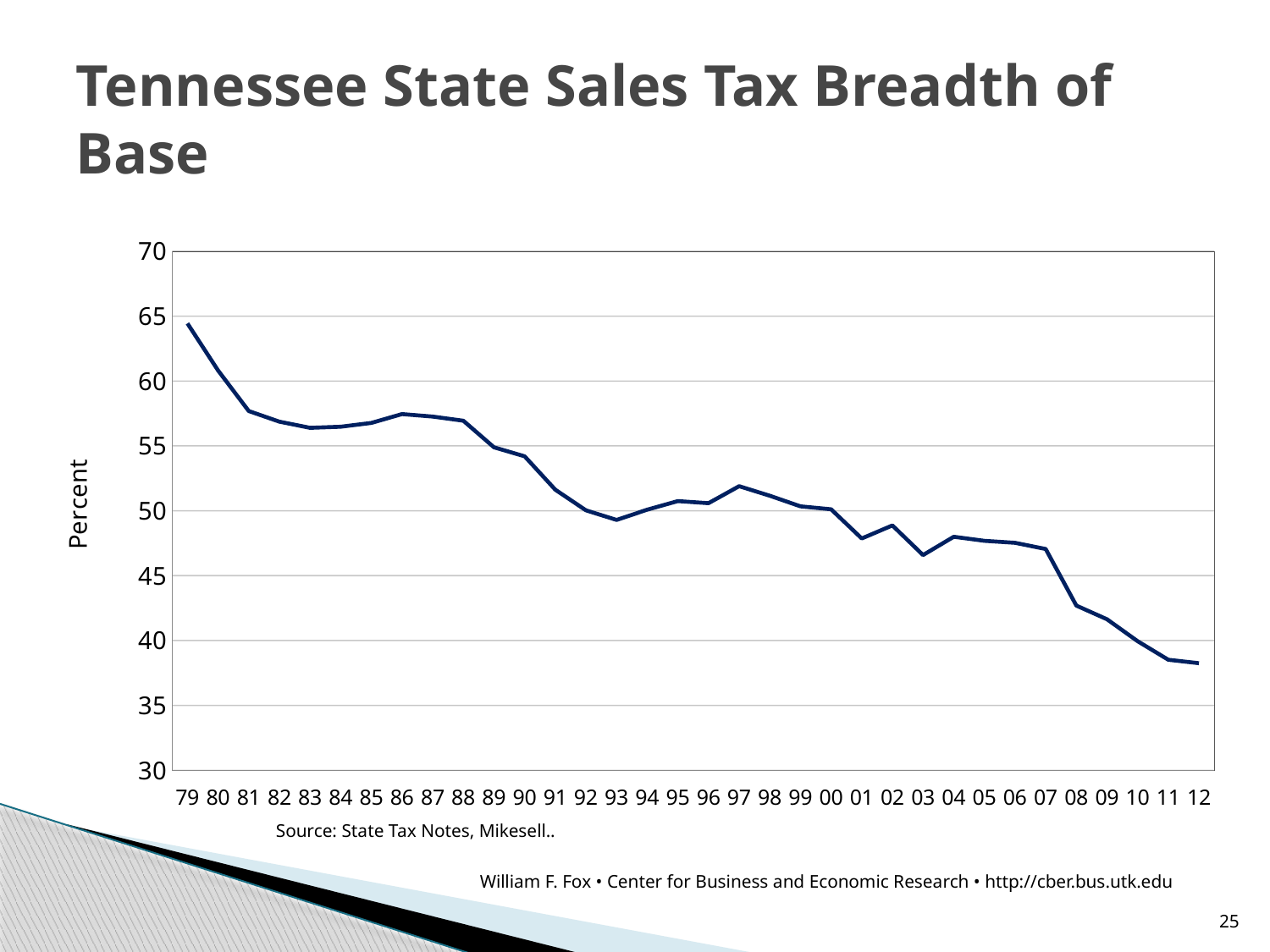
Which year has the larger value, 86 or 03? 86 Is the value for 03 greater or less than 50? less Is the value for 08 greater or less than 45? less Overall, do the values rise or fall from 79 to 12? fall Is the value for 79 greater or less than 60? greater What is the label on the vertical axis of the chart? Percent What is the title of the chart on the slide? Tennessee State Sales Tax Breadth of Base What kind of chart is shown on the slide? line chart How many years are plotted along the x axis? 34 Which year has the highest value on the chart? 79